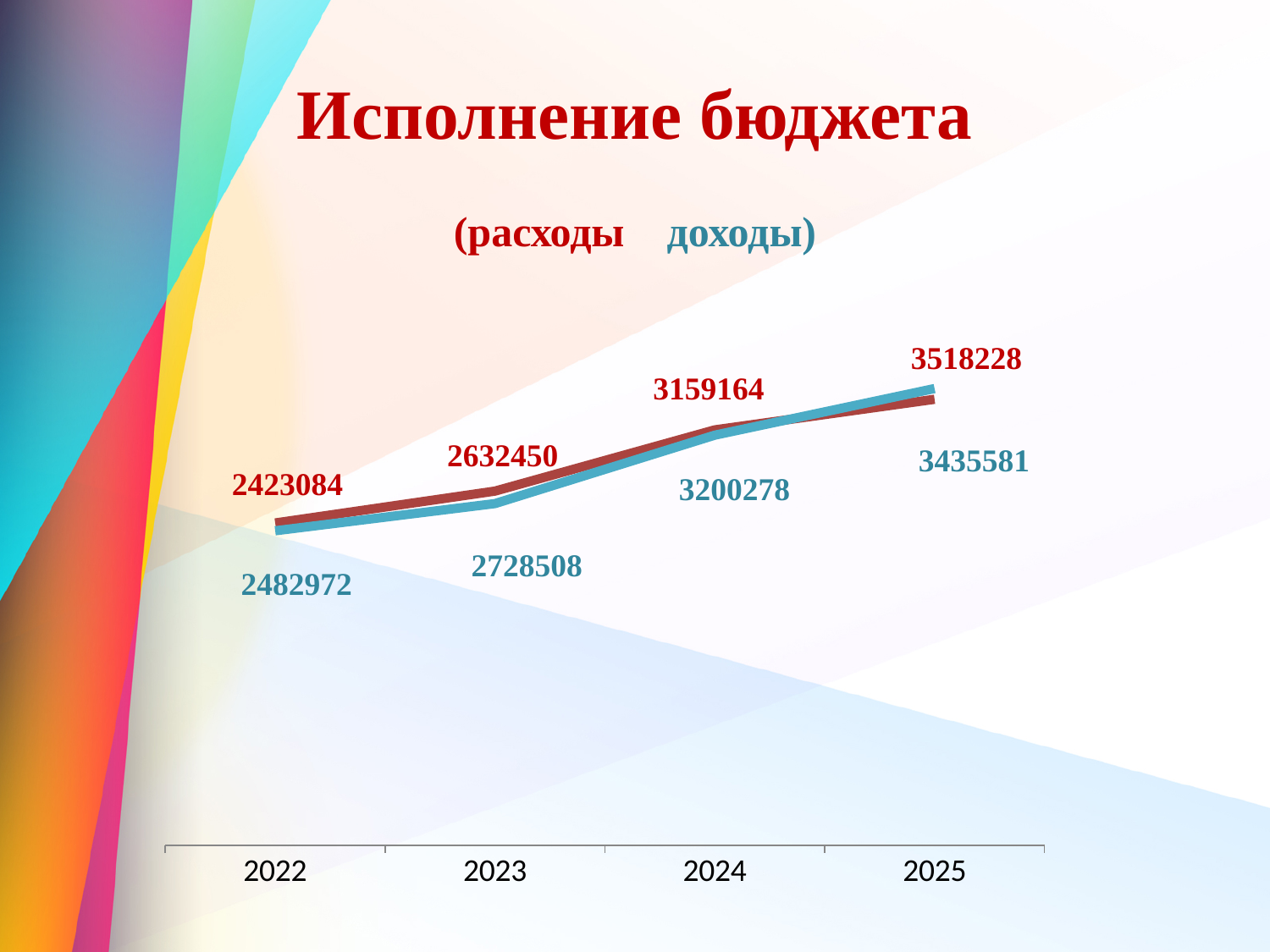
In which year is the value of расходы the highest? 2025 How many years are shown on the x axis? 4 What is the value of расходы for 2024? 3159164 What is the value of доходы for 2025? 3435581 What type of chart is shown on the slide? line chart What is the difference between расходы and доходы in 2025? 82647 In which year is the value of доходы the lowest? 2022 By how much did расходы increase from 2022 to 2025? 1095144 What is the value of расходы for 2022? 2423084 What is the value of доходы for 2023? 2728508 How many data series does the chart show? 2 Which is larger in 2023, расходы or доходы? доходы